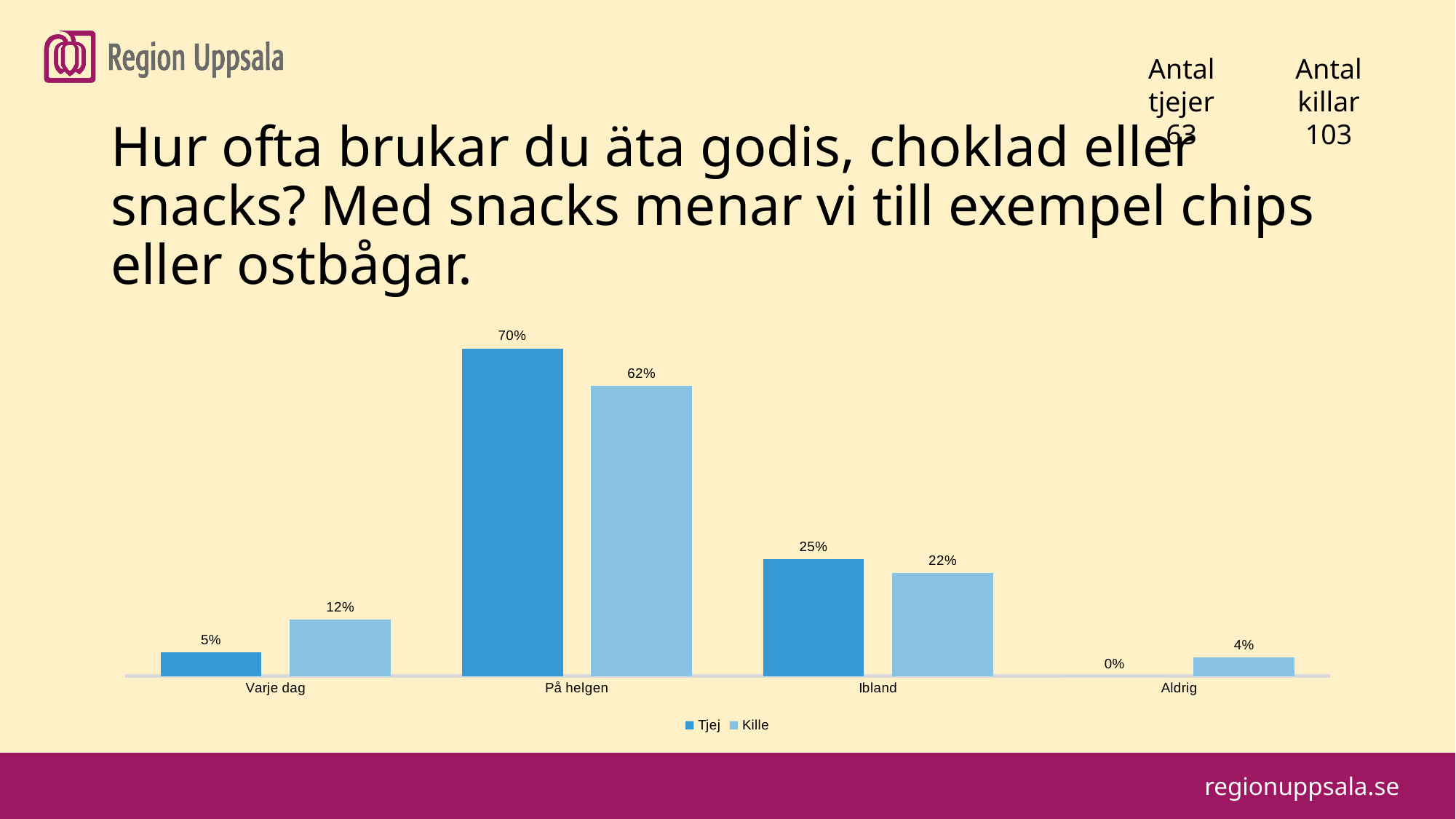
What is the value for Tjej in the Aldrig category? 0% What kind of chart is shown on the slide? Bar chart How many categories are shown on the x axis? 4 How many series does the legend list? 2 What is the value for Kille in the Ibland category? 22% In the Varje dag category, which series has the larger value, Tjej or Kille? Kille Which category has the highest value for Kille? På helgen What is the value for Kille in the Varje dag category? 12% What is the difference between the Tjej and Kille values in the På helgen category? 8% What are the two series names listed in the legend? Tjej and Kille What is the value for Tjej in the På helgen category? 70% Which category has the lowest value for Tjej? Aldrig